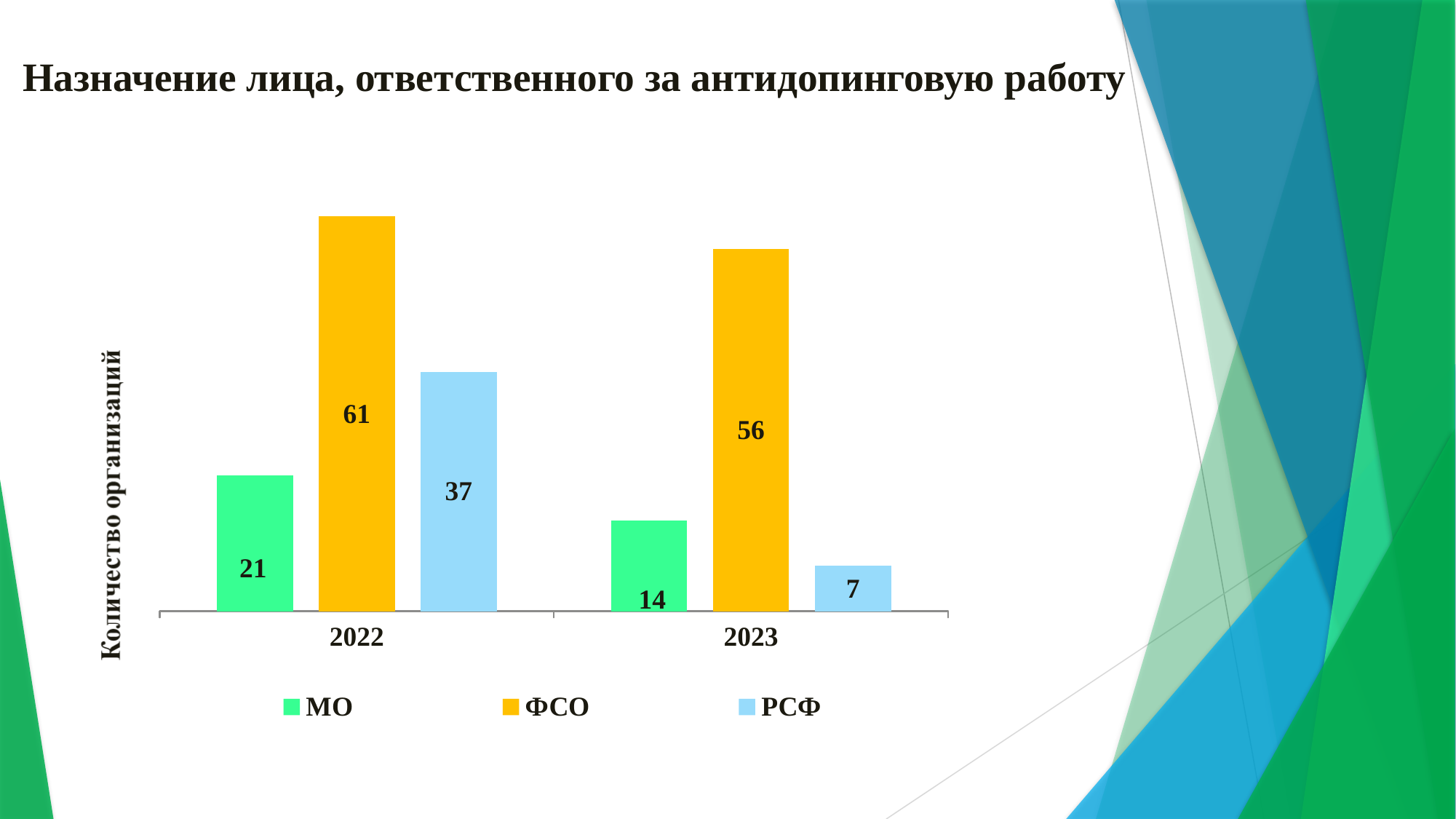
What is the value for МО in 2022? 21 What is the difference between the РСФ values for 2022 and 2023? 30 How many series does the legend list? 3 What is the value for ФСО in 2022? 61 Which is larger, the МО value in 2022 or the МО value in 2023? 2022 How many categories are shown on the x axis? 2 Which series has the highest value in 2023? ФСО Which series has the lowest value in 2023? РСФ What kind of chart is shown on the slide? Bar chart What is the label of the vertical axis? Количество организаций What is the difference between the ФСО values for 2022 and 2023? 5 What is the value for РСФ in 2023? 7